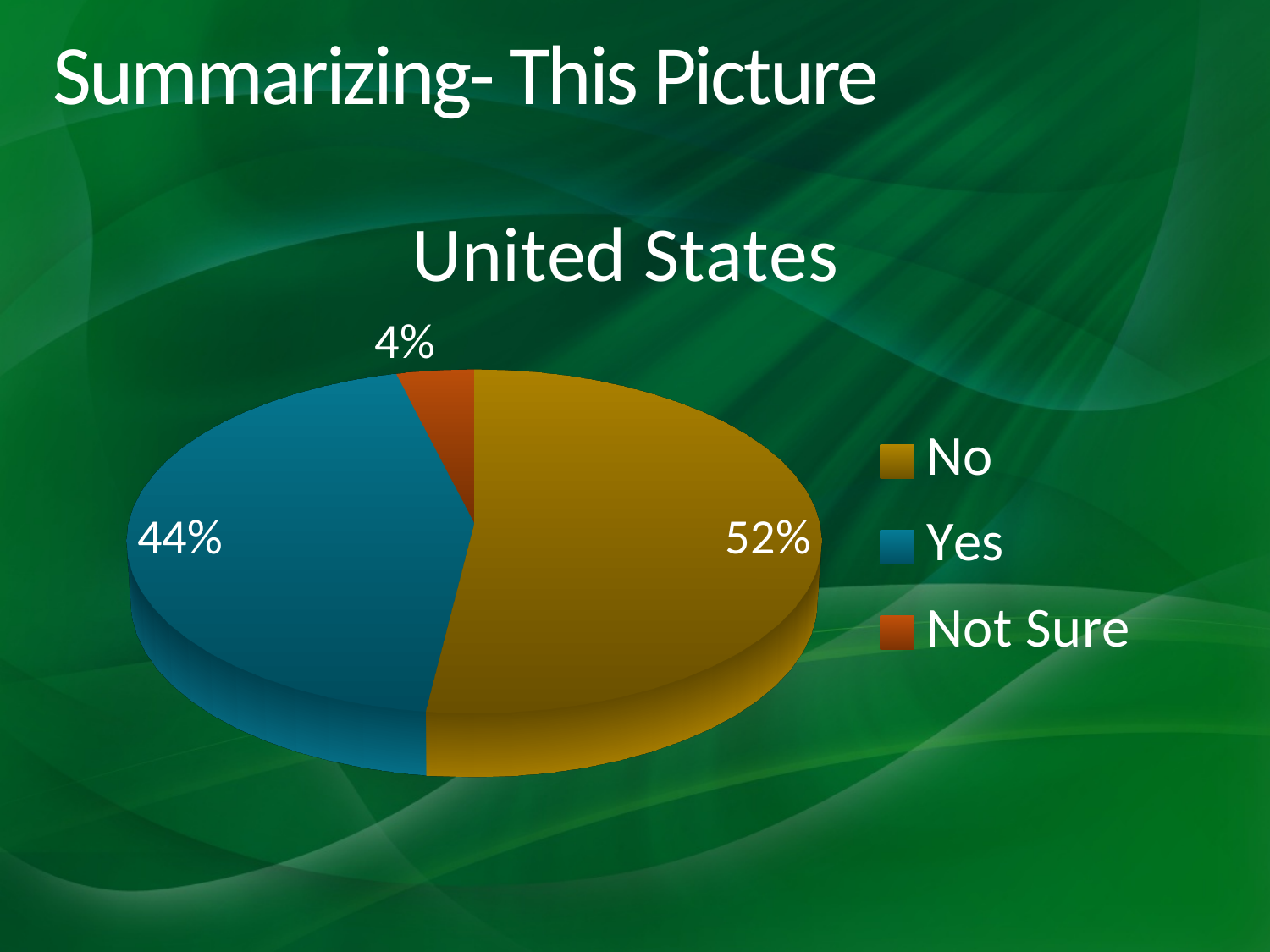
What is the combined share of the "Yes" and "Not Sure" slices? 48% What share of the pie is labelled "No"? 52% Which category has the smallest slice of the pie? Not Sure What is the title of the chart? United States What kind of chart is shown on the slide? Pie chart How many slices does the pie chart have? 3 What share of the pie is labelled "Yes"? 44% What colour is the "Yes" slice? Blue Which category has the largest slice of the pie? No What is the difference in percentage points between the "No" and "Yes" slices? 8 Which is larger, the "Yes" slice or the "Not Sure" slice? Yes What share of the pie is labelled "Not Sure"? 4%